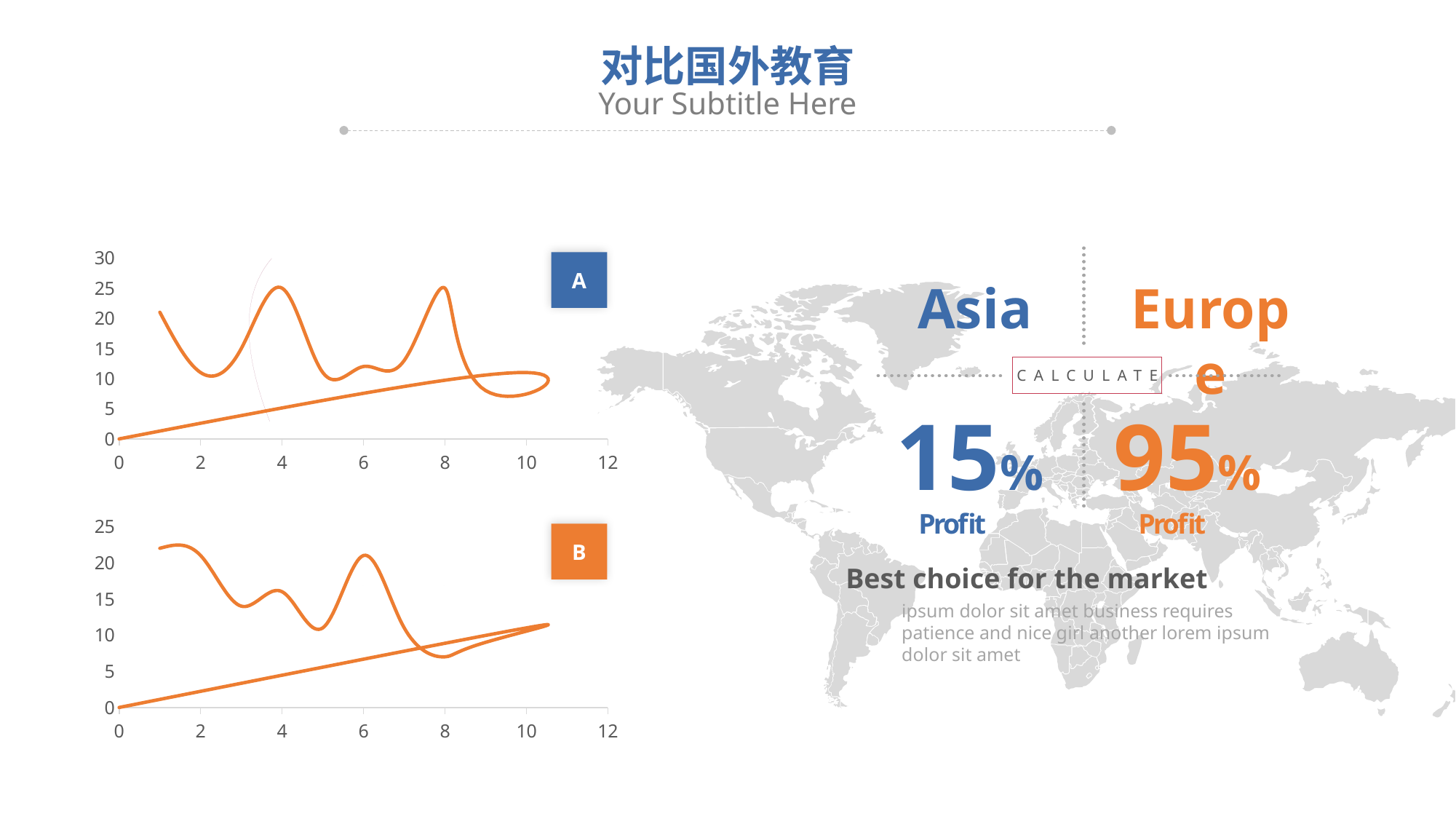
In chart A, does the straight line rise or fall as x increases from 0 to 10? rise What kind of chart is chart A (the top chart on the left)? line chart In chart B, what is the highest value shown on the vertical axis? 25 In chart A, is the value of the wavy line at x = 4 greater or less than 20? greater What kind of chart is chart B (the bottom chart on the left)? line chart In chart A, is the value of the wavy line at x = 8 greater or less than 20? greater In chart A, what is the highest value shown on the vertical axis? 30 In chart B, is the value of the wavy line at x = 8 greater or less than 10? less How many charts are shown on the slide? 2